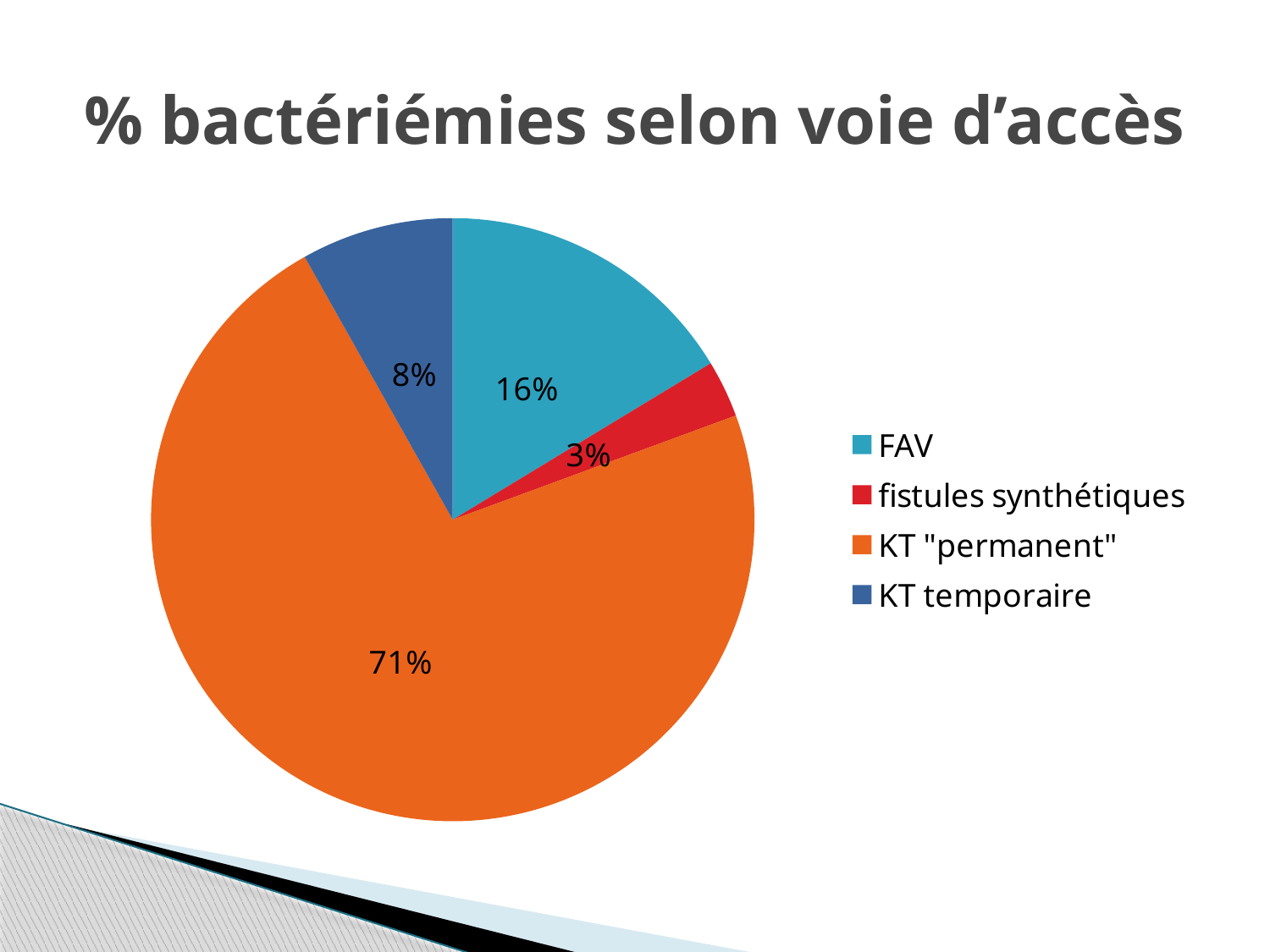
What is the title of the chart? % bactériémies selon voie d’accès How many slices does the pie chart have? 4 Which access route has the largest share of bacteremias? KT "permanent" How many entries does the legend list? 4 Which is larger, the share for FAV or the share for KT temporaire? FAV What is the difference in percentage points between KT "permanent" and FAV? 55 What share of the pie do fistules synthétiques represent? 3% Which access route has the smallest share of bacteremias? fistules synthétiques What share of the pie does FAV represent? 16% What share of the pie does KT temporaire represent? 8% What type of chart is shown on the slide? pie chart